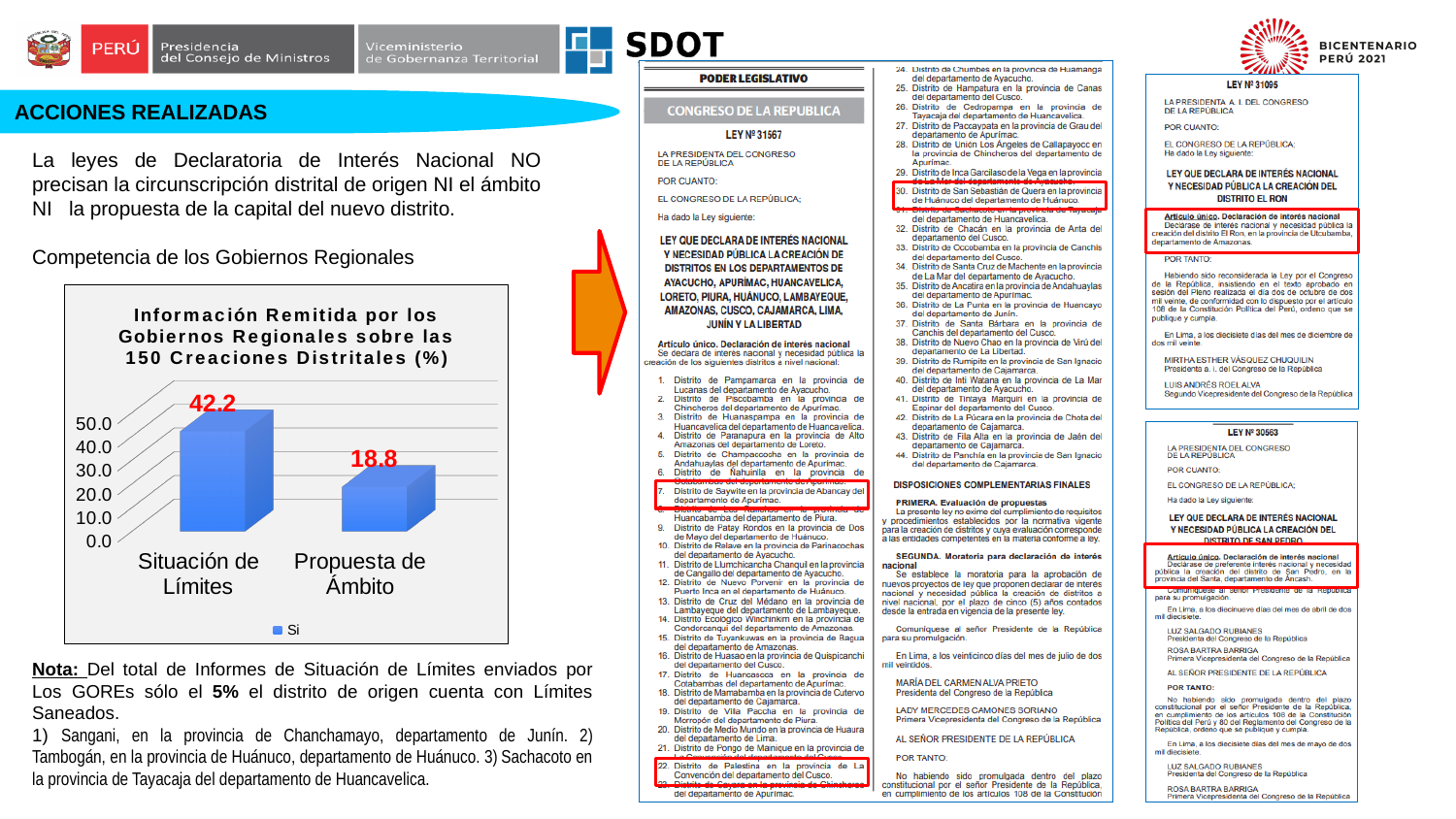
What is the value for Propuesta de Ámbito in the chart? 18.8 Which category has the highest value in the chart? Situación de Límites Is the value for Propuesta de Ámbito greater or less than 20.0? less Which category has the lowest value in the chart? Propuesta de Ámbito How many series does the chart legend list? 1 What is the difference between the values for Situación de Límites and Propuesta de Ámbito? 23.4 Which is larger: the value for Situación de Límites or the value for Propuesta de Ámbito? Situación de Límites What is the series name shown in the chart legend? Si How many categories are shown in the chart? 2 Is the value for Situación de Límites greater or less than 40.0? greater What is the value for Situación de Límites in the chart? 42.2 What kind of chart is shown on the slide? Bar chart